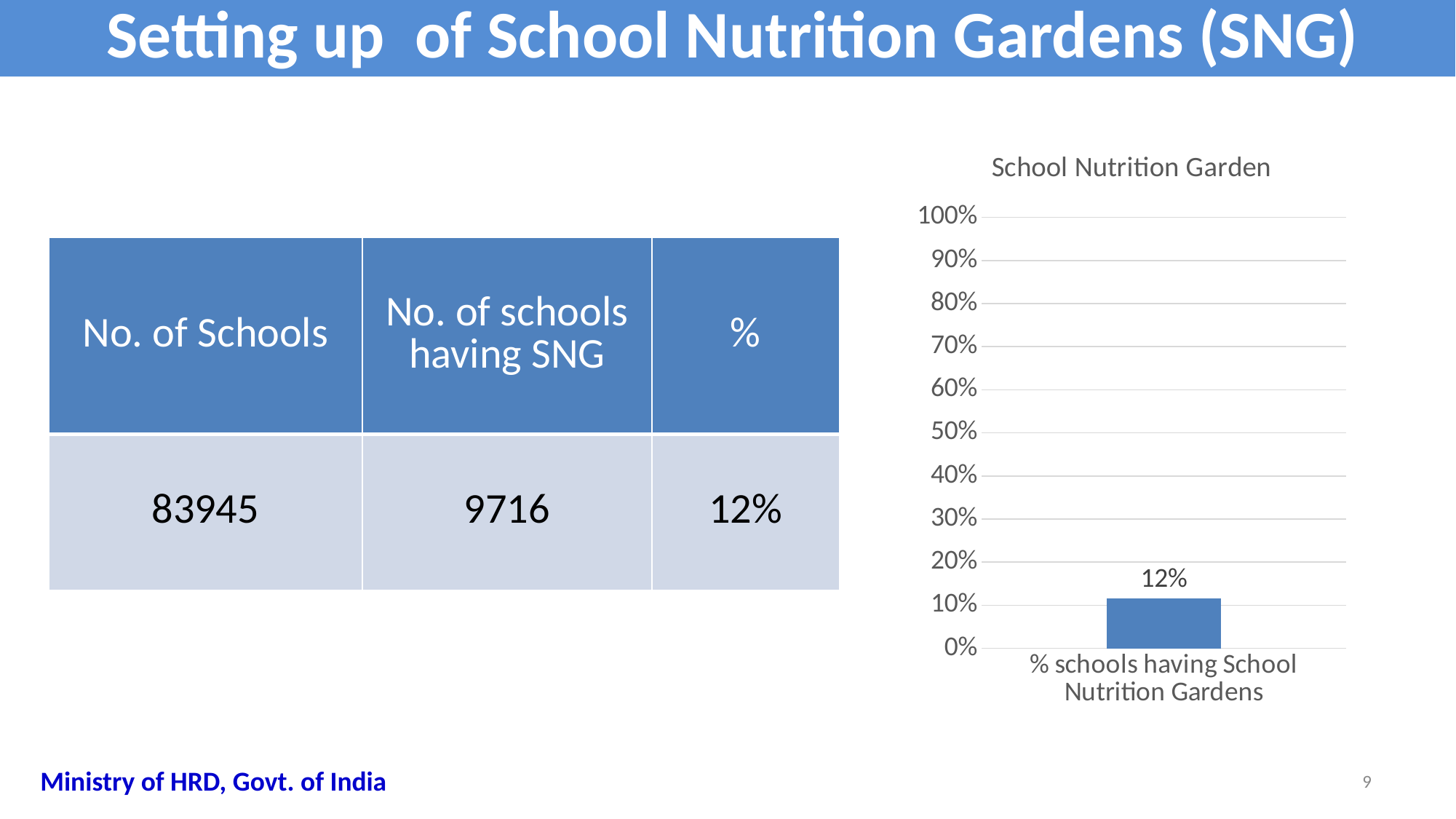
What is the highest value shown on the chart's vertical axis? 100% What is the category label of the bar in the chart? % schools having School Nutrition Gardens What is the title of the chart? School Nutrition Garden Is the value for "% schools having School Nutrition Gardens" greater or less than 50%? less Is the value for "% schools having School Nutrition Gardens" greater or less than 10%? greater What type of chart is shown on the slide? bar chart How many bars are plotted in the chart? 1 What is the value shown for "% schools having School Nutrition Gardens" in the chart? 12%